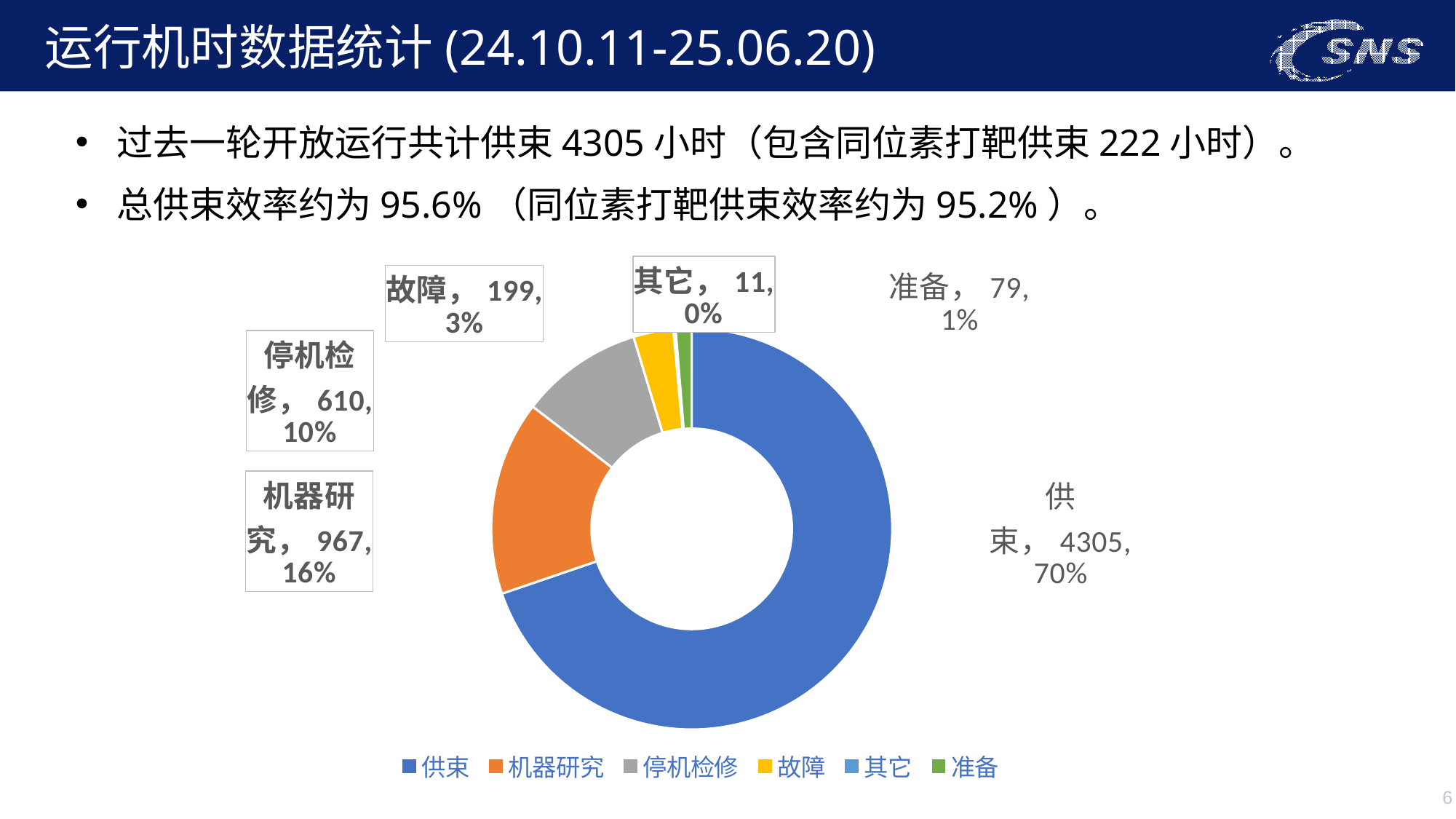
Which is larger, the value for 准备 or the value for 其它? 准备 How many categories does the legend of the chart list? 6 What value is shown for 停机检修 in the chart? 610 What is the difference between the values for 机器研究 and 停机检修? 357 What kind of chart is shown on the slide? Doughnut (pie) chart Which category has the largest value in the chart? 供束 Which category has the smallest value in the chart? 其它 What percentage share does 供束 have in the chart? 70% What value is shown for 故障 in the chart? 199 How many hours are shown for 供束 in the chart? 4305 What value is shown for 机器研究 in the chart? 967 What percentage share does 机器研究 have in the chart? 16%